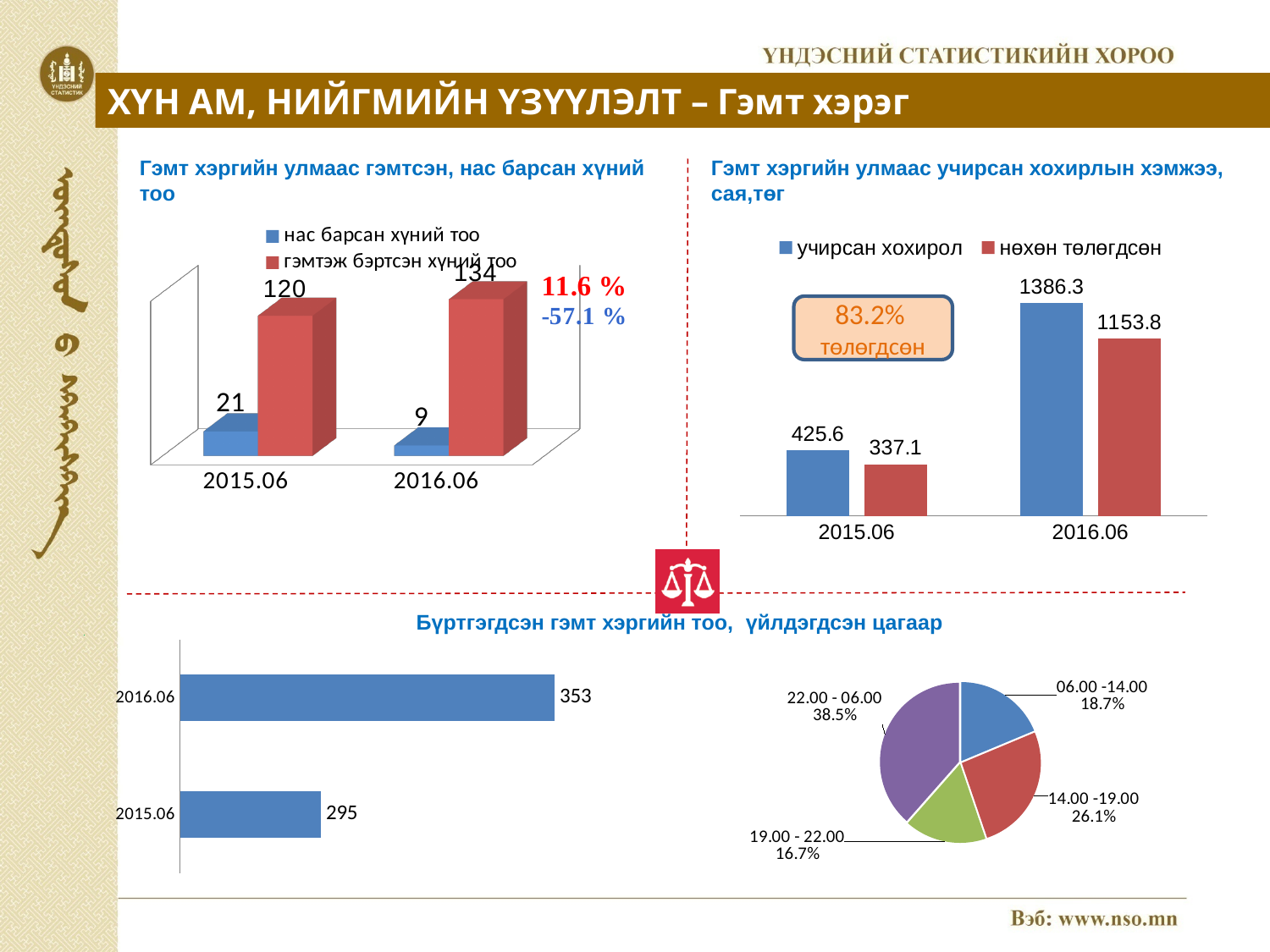
In the top-left chart (Гэмт хэргийн улмаас гэмтсэн, нас барсан хүний тоо), how many series does the legend list? 2 In the top-right chart (Гэмт хэргийн улмаас учирсан хохирлын хэмжээ, сая,төг), which is larger in 2016.06: учирсан хохирол or нөхөн төлөгдсөн? учирсан хохирол In the bottom-left chart (Бүртгэгдсэн гэмт хэргийн тоо), what is the difference between 2016.06 and 2015.06? 58 In the top-right chart (Гэмт хэргийн улмаас учирсан хохирлын хэмжээ, сая,төг), what is the difference between учирсан хохирол in 2016.06 and 2015.06? 960.7 In the bottom-right pie chart (үйлдэгдсэн цагаар), which time slot has the largest share? 22.00 - 06.00 In the top-left chart (Гэмт хэргийн улмаас гэмтсэн, нас барсан хүний тоо), what is the difference between гэмтэж бэртсэн хүний тоо in 2016.06 and 2015.06? 14 In the top-left chart (Гэмт хэргийн улмаас гэмтсэн, нас барсан хүний тоо), what is the value for нас барсан хүний тоо in 2015.06? 21 In the bottom-left chart (Бүртгэгдсэн гэмт хэргийн тоо), what is the value for 2016.06? 353 In the top-right chart (Гэмт хэргийн улмаас учирсан хохирлын хэмжээ, сая,төг), what is the value for нөхөн төлөгдсөн in 2015.06? 337.1 In the top-right chart (Гэмт хэргийн улмаас учирсан хохирлын хэмжээ, сая,төг), what is the value for учирсан хохирол in 2016.06? 1386.3 In the top-left chart (Гэмт хэргийн улмаас гэмтсэн, нас барсан хүний тоо), what is the value for гэмтэж бэртсэн хүний тоо in 2016.06? 134 In the bottom-right pie chart (үйлдэгдсэн цагаар), what share does 14.00 -19.00 have? 26.1%